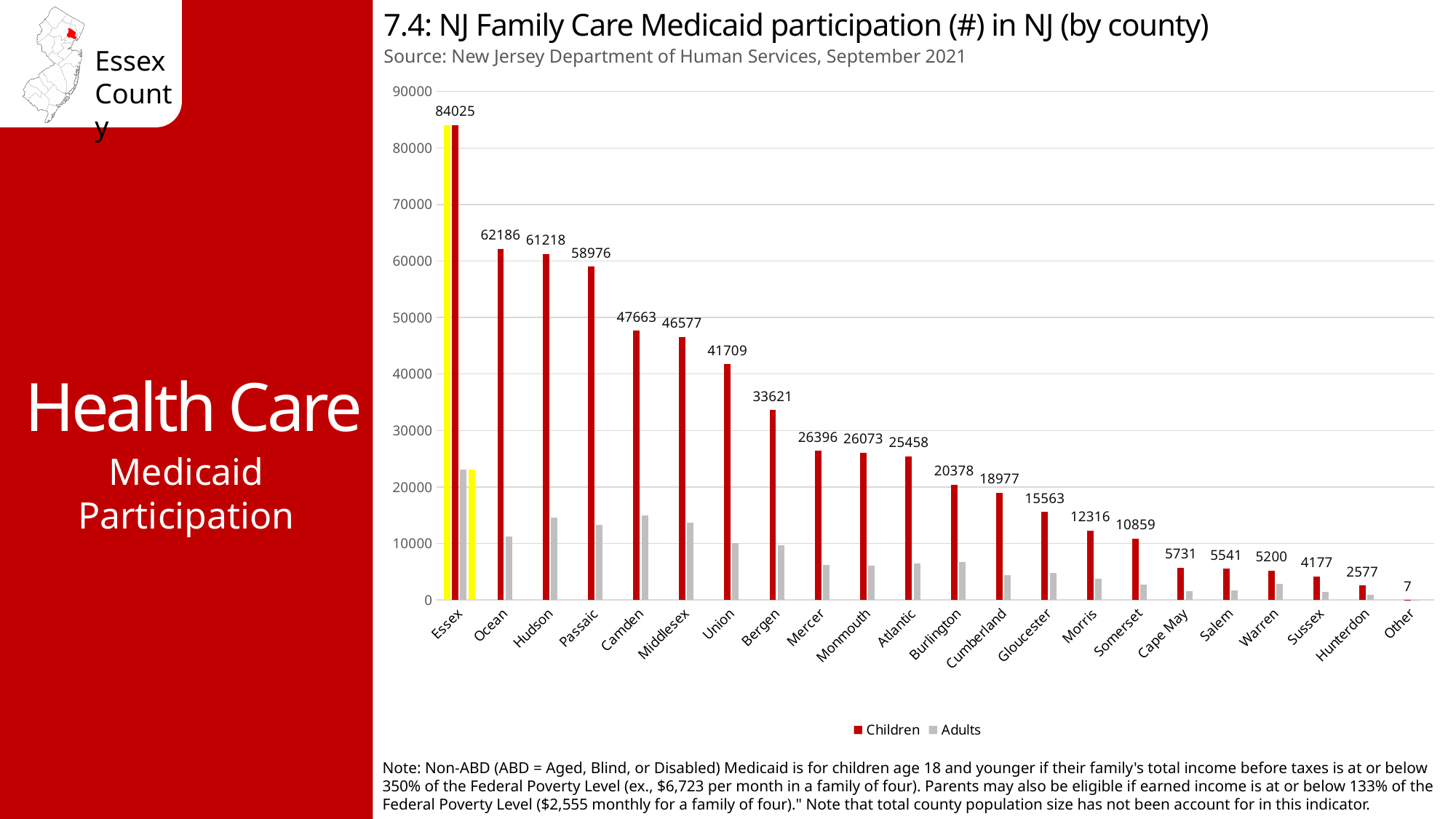
What kind of chart is shown? bar chart Which has a larger Children value, Union or Bergen? Union How many categories are shown on the x axis? 22 What is the Children value for Essex? 84025 What is the difference between the Children values for Ocean and Hudson? 968 Is the Adults value for Ocean greater or less than 20000? less Is the Adults value for Essex greater or less than 20000? greater What is the Children value for Camden? 47663 Which county has the highest Children value? Essex Which category has the lowest Children value? Other How many series does the legend list? 2 What is the Children value for Gloucester? 15563